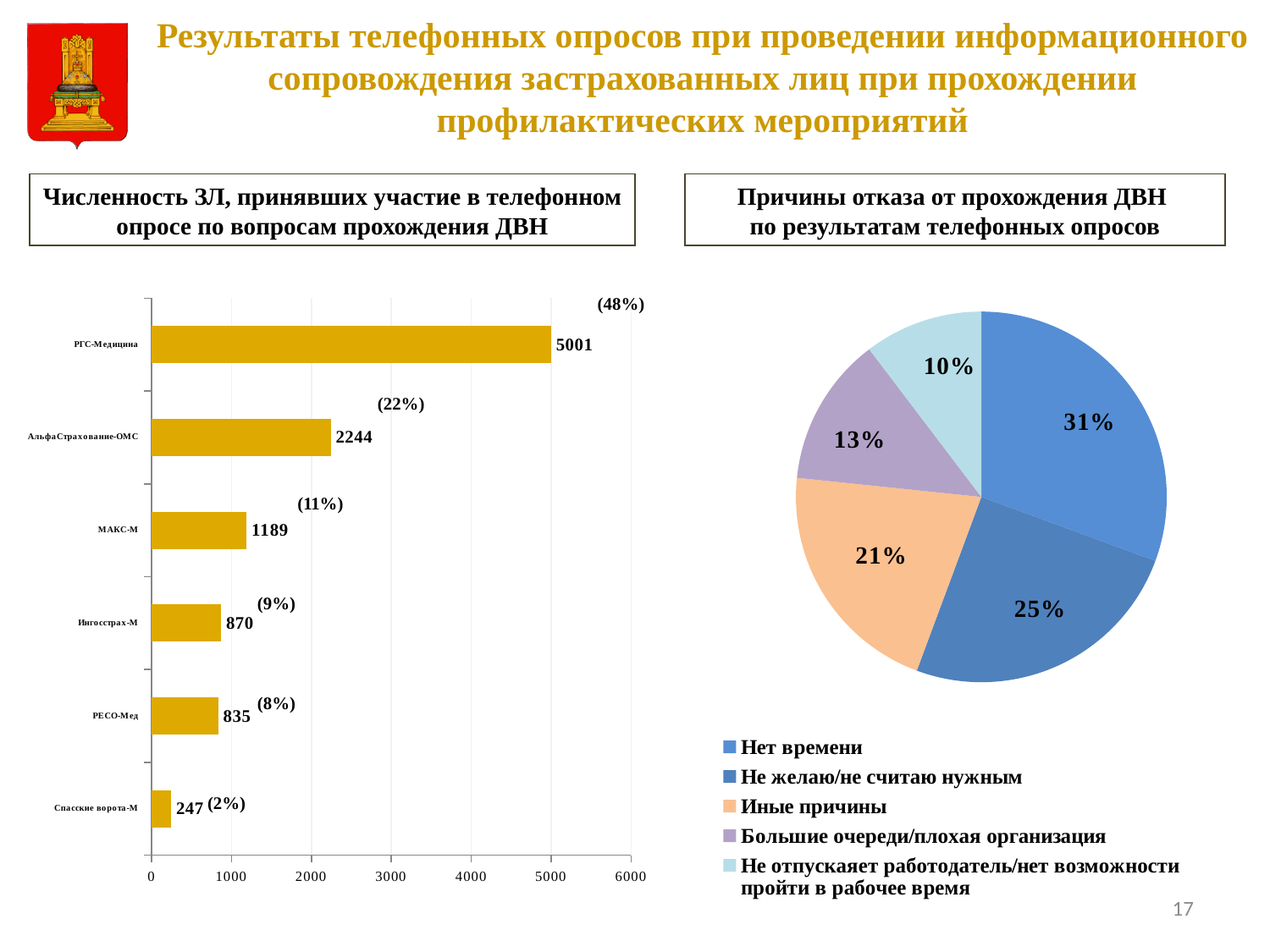
What type of chart is the chart on the left of the slide? Bar chart How many entries does the legend of the right pie chart list? 5 In the right pie chart, which category has the smallest slice? Не отпускает работодатель/нет возможности пройти в рабочее время In the left bar chart, which category has the lowest value? Спасские ворота-М In the left bar chart, what is the value for Ингосстрах-М? 870 In the left bar chart, which category has the highest value? РГС-Медицина In the left bar chart, which is larger: the value for РЕСО-Мед or the value for Спасские ворота-М? РЕСО-Мед In the right pie chart, what share does the slice for Большие очереди/плохая организация have? 13% In the left bar chart, what is the value for РГС-Медицина? 5001 In the left bar chart, what is the difference between the values for АльфаСтрахование-ОМС and МАКС-М? 1055 How many categories are shown in the left bar chart? 6 In the right pie chart, what share does the slice for Нет времени have? 31%